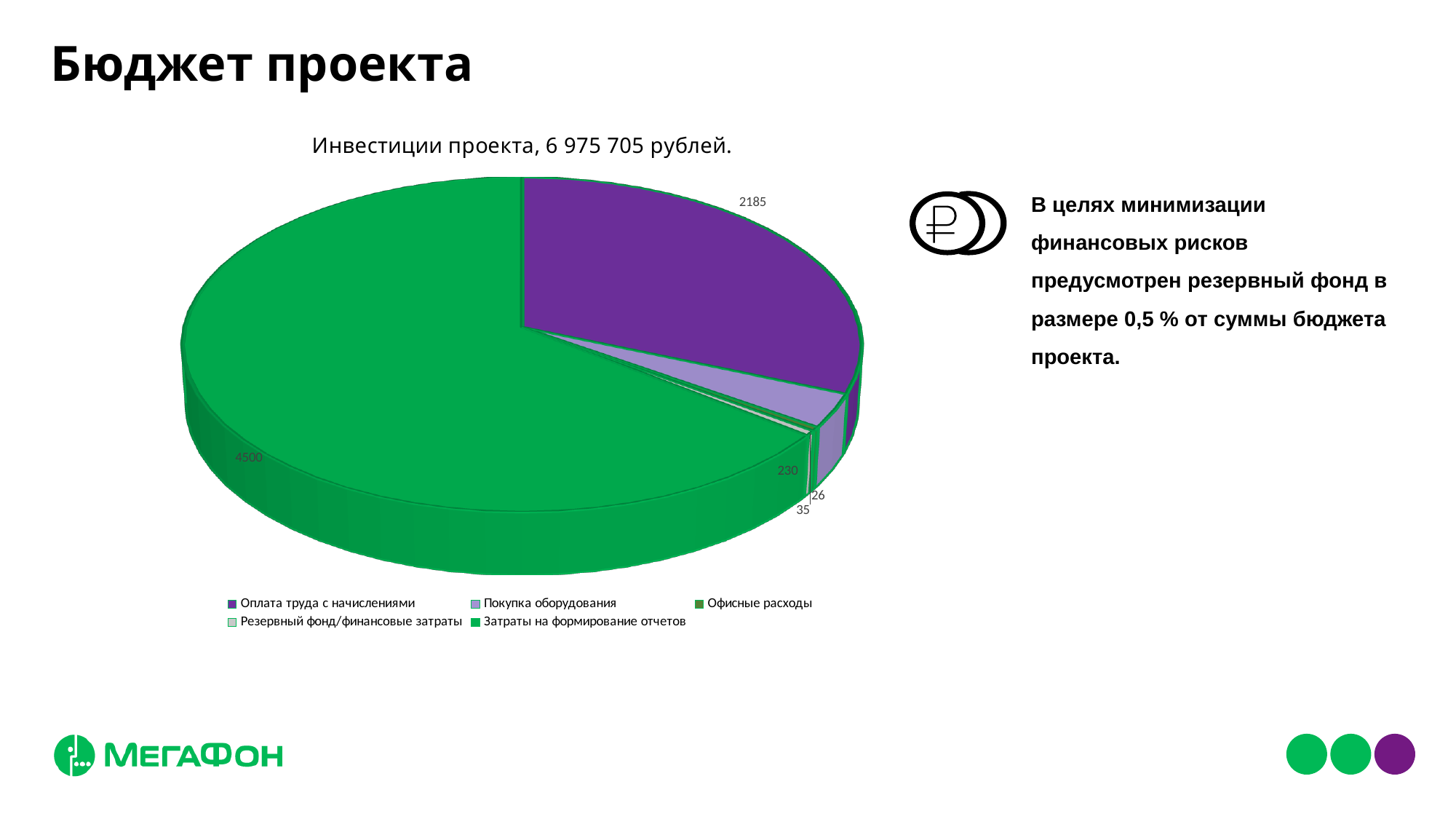
What is the value for Оплата труда с начислениями? 2185 Which is larger: Оплата труда с начислениями or Покупка оборудования? Оплата труда с начислениями What colour is the slice for Оплата труда с начислениями? Purple What kind of chart is shown on the slide? Pie chart Which category has the smallest slice of the pie? Офисные расходы What is the value for Резервный фонд/финансовые затраты? 35 What is the title of the chart? Инвестиции проекта, 6 975 705 рублей. Which category has the largest slice of the pie? Затраты на формирование отчетов What is the value for Покупка оборудования? 230 What is the value for Затраты на формирование отчетов? 4500 What is the difference between the values for Затраты на формирование отчетов and Оплата труда с начислениями? 2315 How many categories does the pie chart have? 5